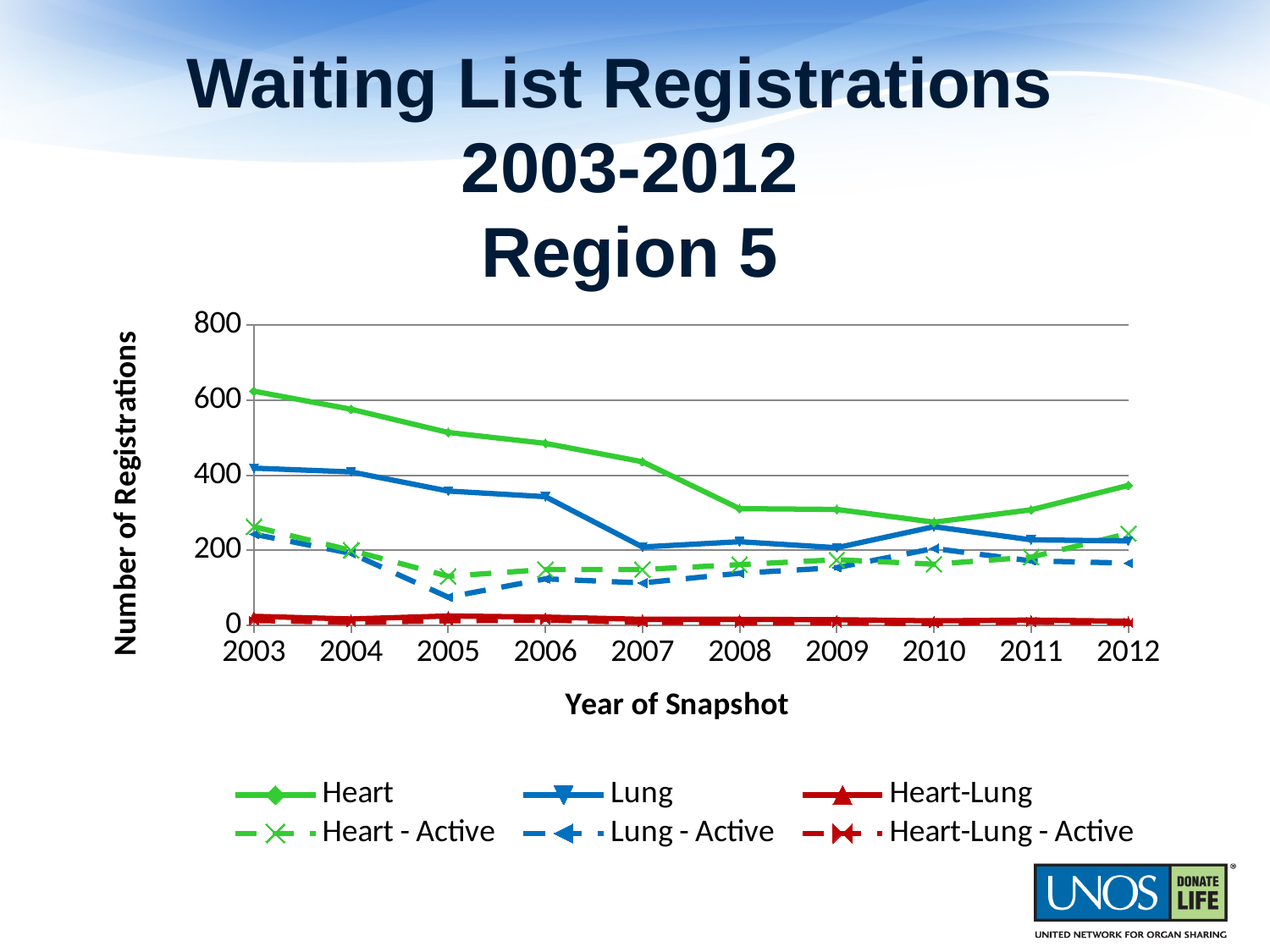
How many series does the legend list? 6 What is the label of the y axis? Number of Registrations Is the value for Heart in 2012 greater or less than 400? less Is the value for Lung in 2005 greater or less than 400? less Which series has the highest value in 2003? Heart How many years are plotted along the x axis? 10 In which year is the Heart series at its highest? 2003 In which year is the Heart series at its lowest? 2010 Is the value for Lung - Active in 2005 greater or less than 200? less Does the Heart series rise or fall from 2003 to 2010? Fall What kind of chart is shown on the slide? Line chart